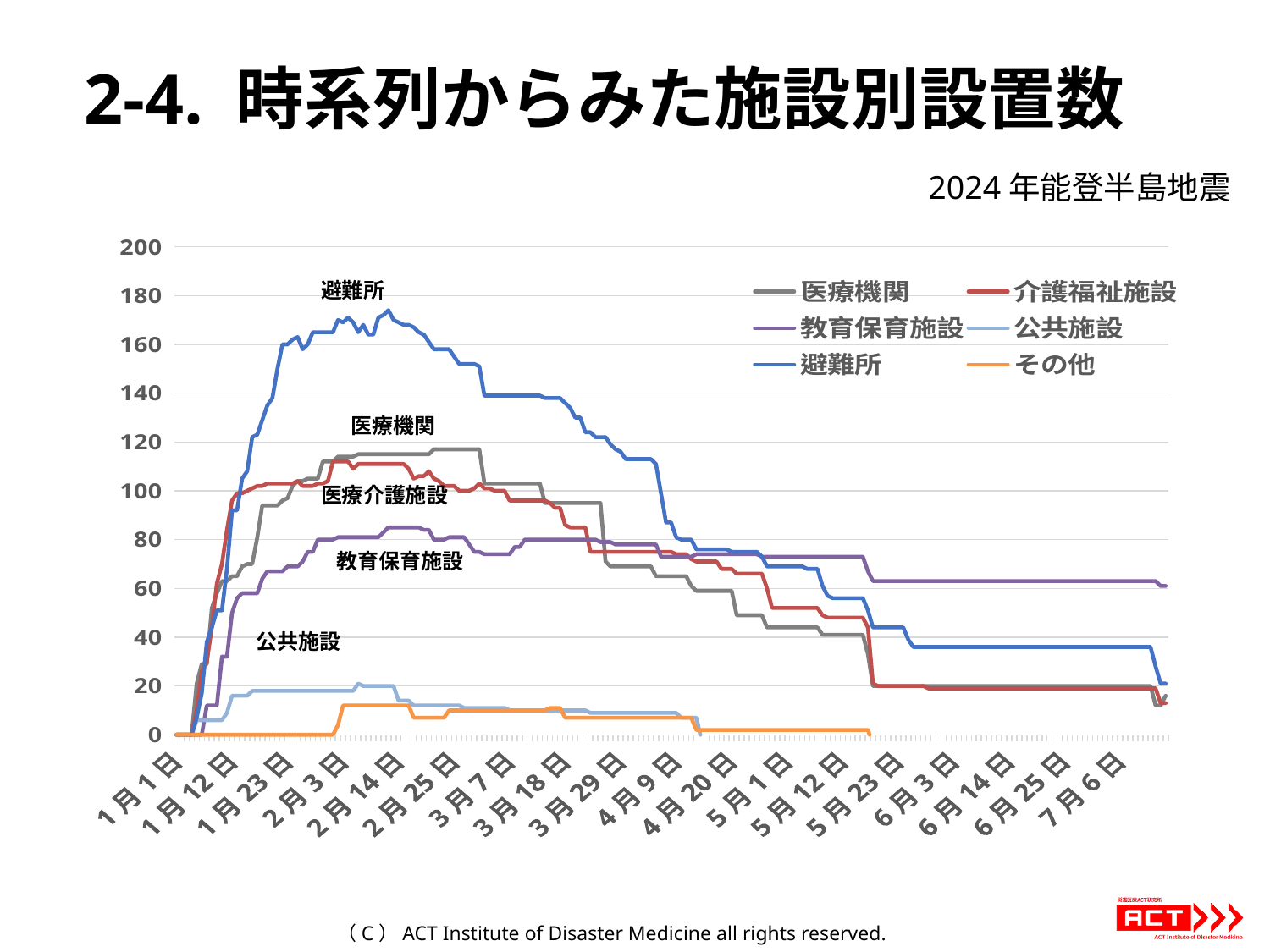
Is the peak value for その他 greater or less than 20? less Does the 避難所 line rise or fall between 2月14日 and 7月6日? fall How many series does the legend list? 6 What kind of chart is shown on the slide? line chart At 6月3日, which series has the higher value: 教育保育施設 or 避難所? 教育保育施設 Is the peak value for 医療機関 greater or less than 100? greater Is the peak value for 公共施設 greater or less than 40? less What colour is the 避難所 line in the legend? blue What is the highest value shown on the vertical axis? 200 Which series reaches the highest value on the chart? 避難所